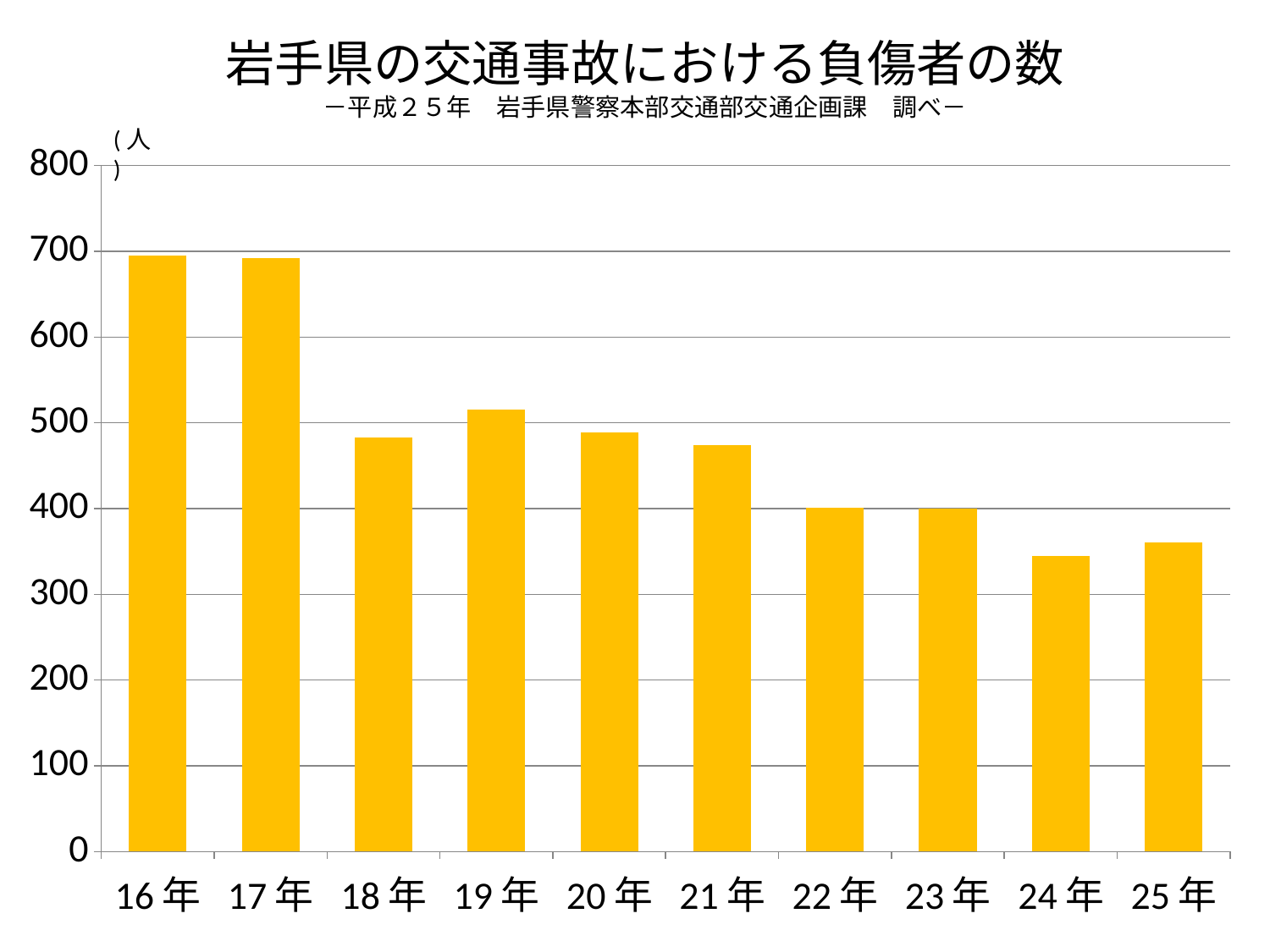
Which is larger, the value for 21年 or the value for 22年? 21年 Is the value for 19年 greater or less than 500? greater Which year has the lowest number of injured persons? 24年 Is the value for 18年 greater or less than 500? less Is the value for 24年 greater or less than 400? less What kind of chart is shown on the slide? bar chart Overall, do the values rise or fall from 16年 to 25年? fall What unit is shown on the y axis of the chart? 人 How many years (categories) are shown on the x axis? 10 Which is larger, the value for 18年 or the value for 19年? 19年